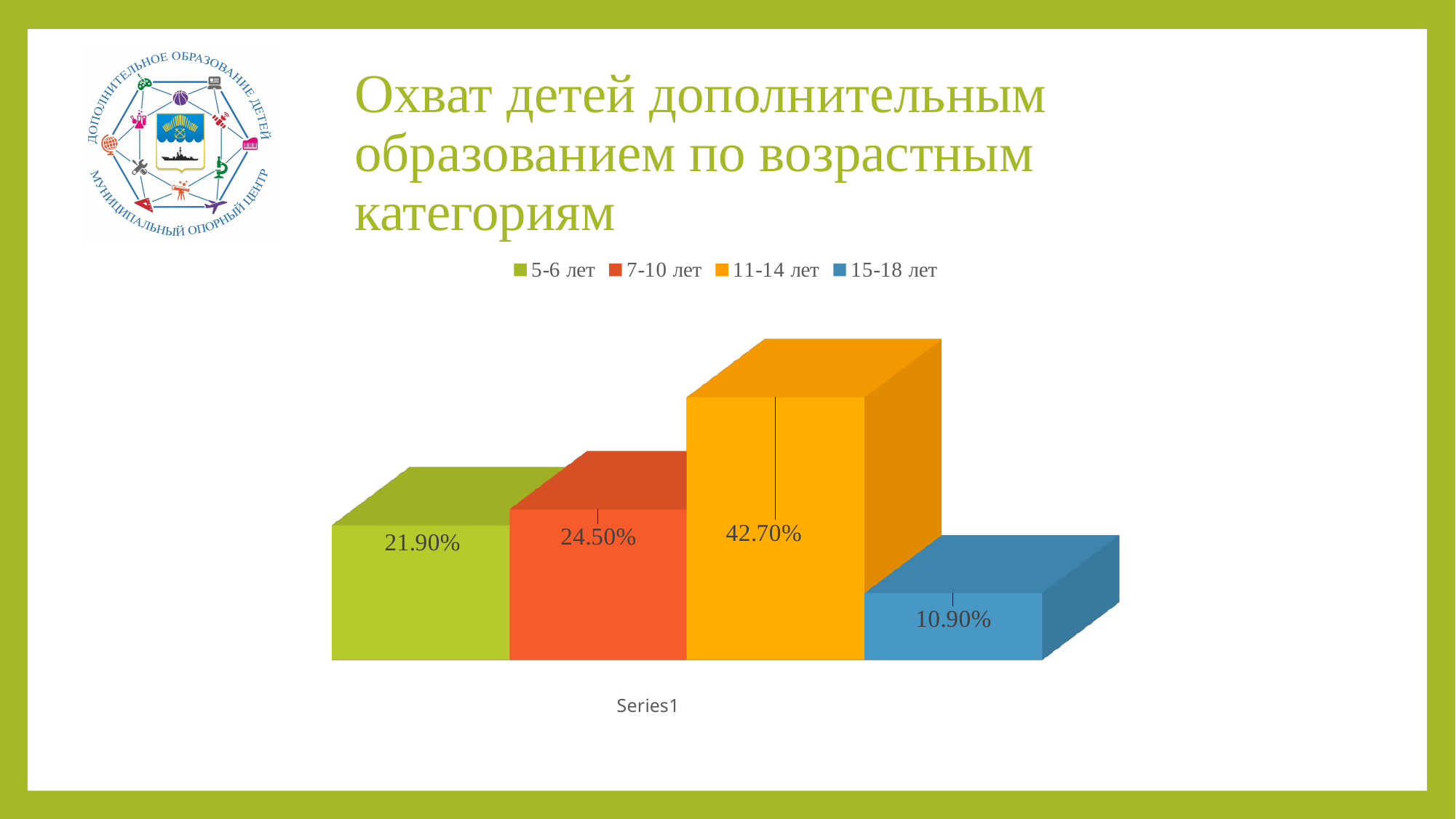
Which age group has the lowest value? 15-18 лет What is the value for the 15-18 лет age group? 10.90% What is the difference between the values for 7-10 лет and 5-6 лет? 2.60% What colour is the bar for the 11-14 лет age group? Orange Which is larger, the value for 7-10 лет or the value for 5-6 лет? 7-10 лет What is the value for the 7-10 лет age group? 24.50% Which age group has the highest value? 11-14 лет What kind of chart is shown on the slide? Bar chart What is the difference between the values for 11-14 лет and 15-18 лет? 31.80% What is the value for the 11-14 лет age group? 42.70% How many age groups are shown in the chart? 4 What is the value for the 5-6 лет age group? 21.90%